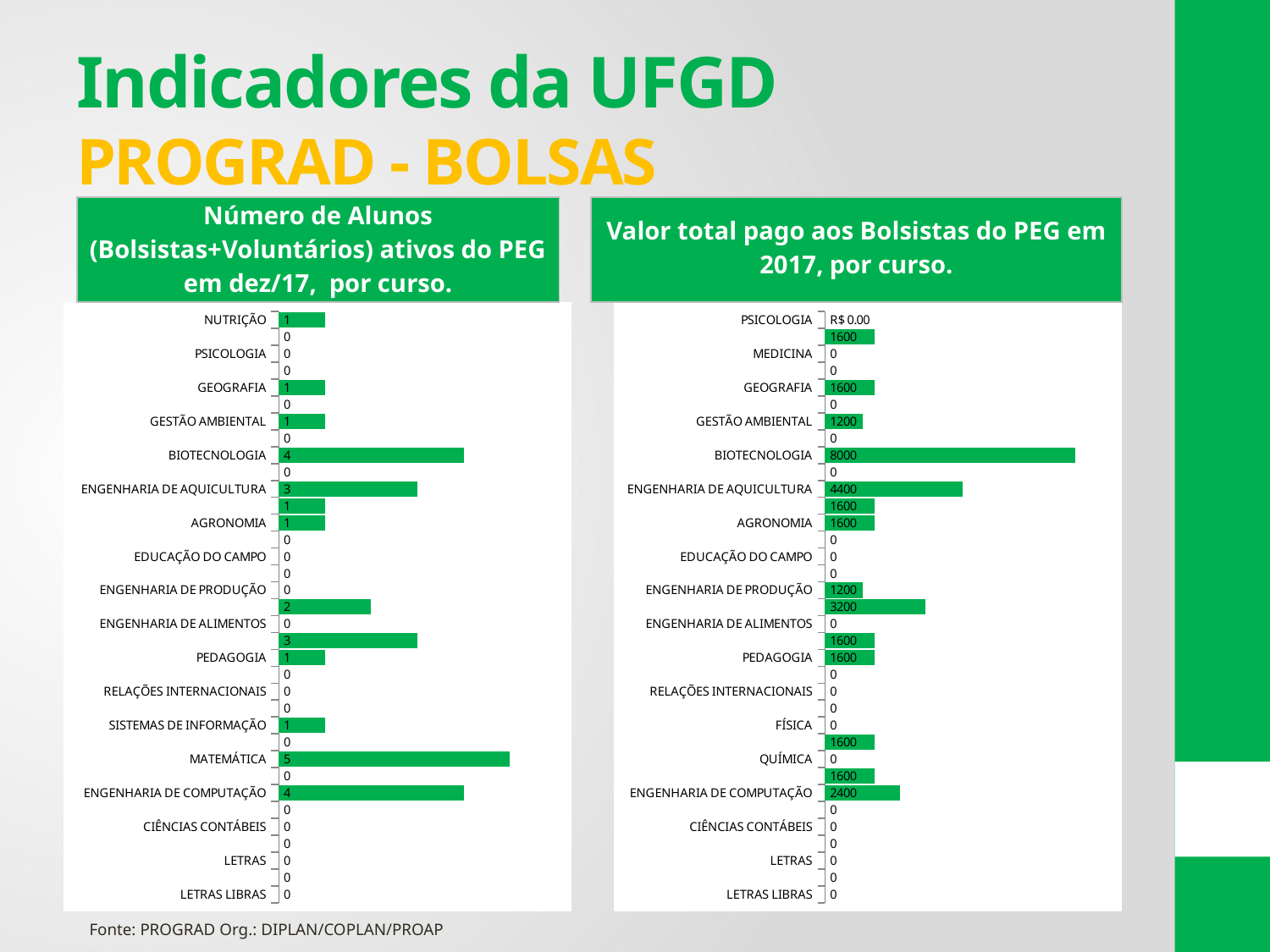
What type of chart is the chart on the right of the slide? Bar chart In the chart 'Valor total pago aos Bolsistas do PEG em 2017, por curso', what is the value for ENGENHARIA DE COMPUTAÇÃO? 2400 In the chart 'Número de Alunos (Bolsistas+Voluntários) ativos do PEG em dez/17, por curso', what is the difference between MATEMÁTICA and ENGENHARIA DE AQUICULTURA? 2 In the chart 'Valor total pago aos Bolsistas do PEG em 2017, por curso', which is larger: GESTÃO AMBIENTAL or ENGENHARIA DE COMPUTAÇÃO? ENGENHARIA DE COMPUTAÇÃO In the chart 'Valor total pago aos Bolsistas do PEG em 2017, por curso', what is the difference between BIOTECNOLOGIA and ENGENHARIA DE AQUICULTURA? 3600 In the chart 'Número de Alunos (Bolsistas+Voluntários) ativos do PEG em dez/17, por curso', what is the value for BIOTECNOLOGIA? 4 In the chart 'Número de Alunos (Bolsistas+Voluntários) ativos do PEG em dez/17, por curso', which is larger: BIOTECNOLOGIA or PEDAGOGIA? BIOTECNOLOGIA In the chart 'Número de Alunos (Bolsistas+Voluntários) ativos do PEG em dez/17, por curso', what is the value for MATEMÁTICA? 5 What is the title of the chart on the left of the slide? Número de Alunos (Bolsistas+Voluntários) ativos do PEG em dez/17, por curso. In the chart 'Número de Alunos (Bolsistas+Voluntários) ativos do PEG em dez/17, por curso', which labeled course has the highest value? MATEMÁTICA In the chart 'Valor total pago aos Bolsistas do PEG em 2017, por curso', what is the value for BIOTECNOLOGIA? 8000 In the chart 'Valor total pago aos Bolsistas do PEG em 2017, por curso', which labeled course has the highest value? BIOTECNOLOGIA